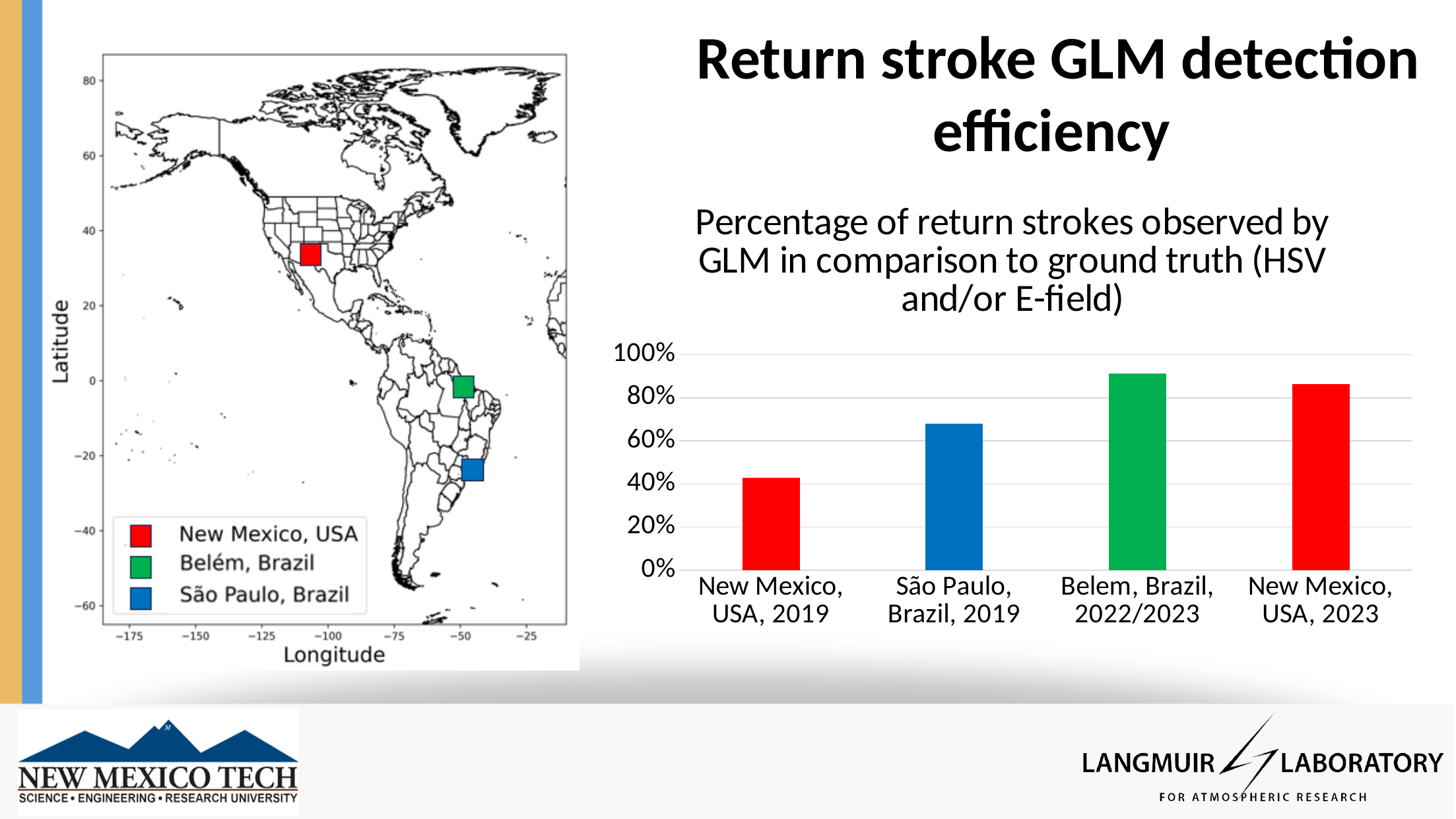
Which category has the highest value in the bar chart? Belem, Brazil, 2022/2023 Is the value for Belem, Brazil, 2022/2023 greater or less than 80%? greater What is the title of the bar chart? Percentage of return strokes observed by GLM in comparison to ground truth (HSV and/or E-field) What colour is the bar for Belem, Brazil, 2022/2023? green Is the value for New Mexico, USA, 2019 greater or less than 60%? less Is the value for São Paulo, Brazil, 2019 greater or less than 60%? greater What kind of chart is shown on the right side of the slide? bar chart Which is larger in the bar chart: the value for New Mexico, USA, 2023 or the value for New Mexico, USA, 2019? New Mexico, USA, 2023 Which category has the lowest value in the bar chart? New Mexico, USA, 2019 Which is larger in the bar chart: the value for New Mexico, USA, 2019 or the value for São Paulo, Brazil, 2019? São Paulo, Brazil, 2019 How many bars (categories) does the bar chart show? 4